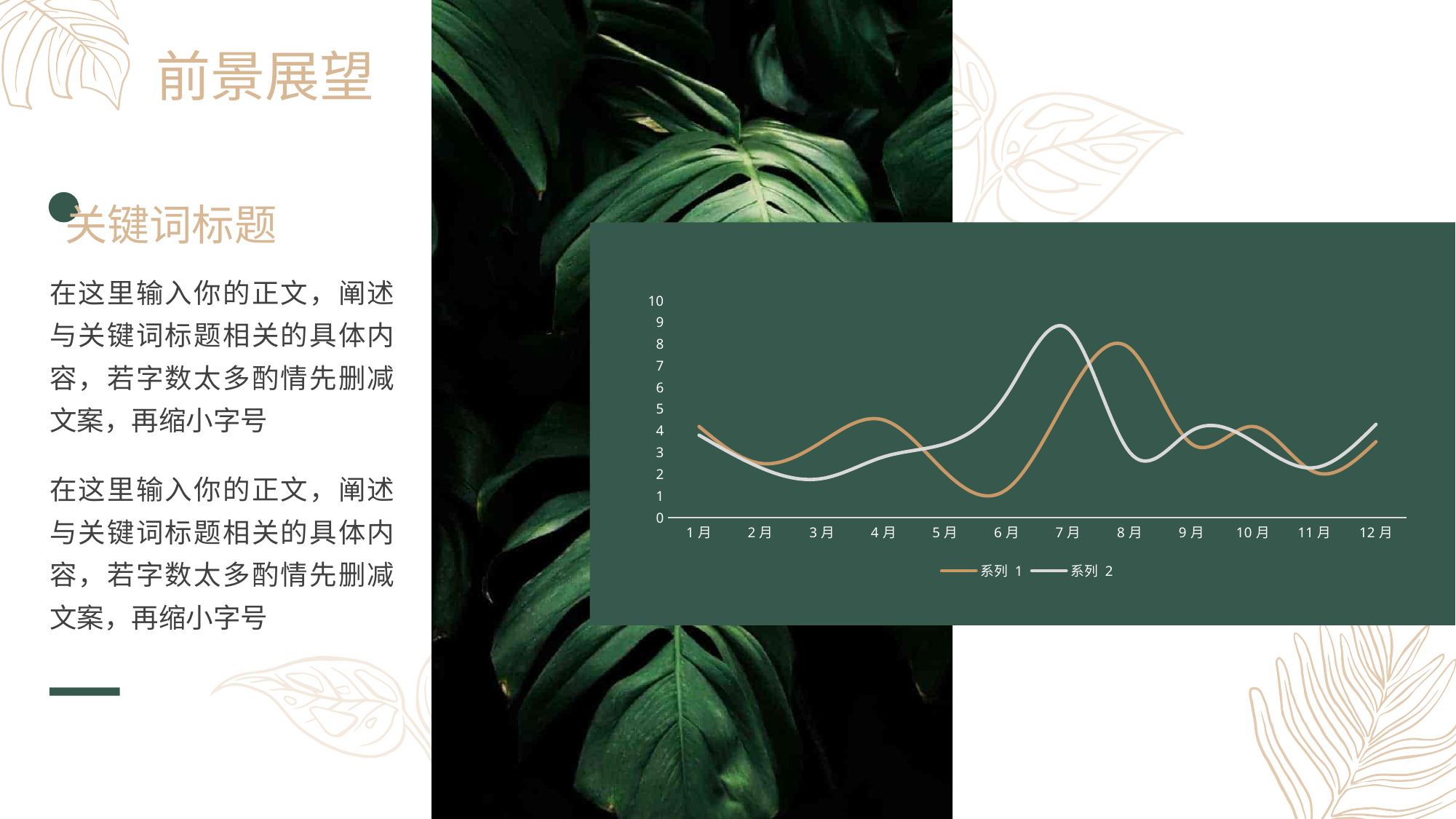
In which month does 系列 1 reach its lowest value? 6月 What kind of chart is shown on the slide? Line chart Does 系列 2 rise or fall from 3月 to 7月? Rise Is the value for 系列 1 in 6月 greater or less than 2? less How many categories are shown on the x axis? 12 Is the value for 系列 2 in 7月 greater or less than 8? greater How many series does the legend list? 2 Which series has the higher value in 7月, 系列 1 or 系列 2? 系列 2 In which month does 系列 1 reach its highest value? 8月 What are the two entries listed in the legend? 系列 1 and 系列 2 In which month does 系列 2 reach its highest value? 7月 Is the value for 系列 1 in 8月 greater or less than 6? greater